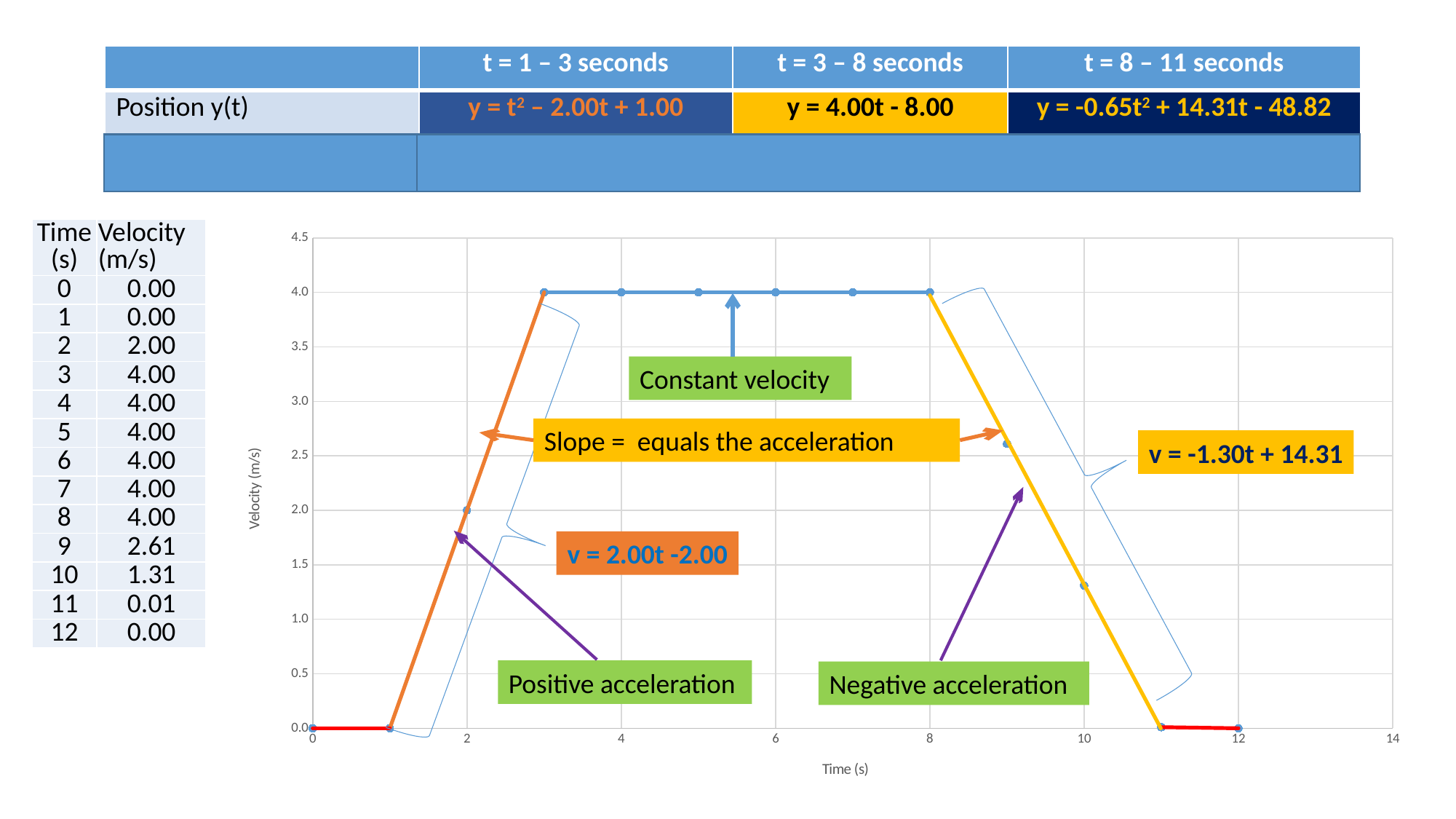
What is the title of the x axis of the chart? Time (s) What equation is shown in the orange label for the rising segment of the chart? v = 2.00t -2.00 What is the velocity at time 9 s? 2.61 What is the difference between the velocity at time 3 s and the velocity at time 2 s? 2.00 What kind of chart is shown on the slide? Line chart How many data points are plotted on the chart? 13 Is the velocity at time 10 s greater or less than 1.5? less What is the velocity at time 10 s? 1.31 Between time 8 s and time 11 s, does the velocity rise or fall? Fall What is the highest velocity value plotted on the chart? 4.00 What is the velocity at time 11 s? 0.01 Which has the larger velocity, time 2 s or time 9 s? Time 9 s